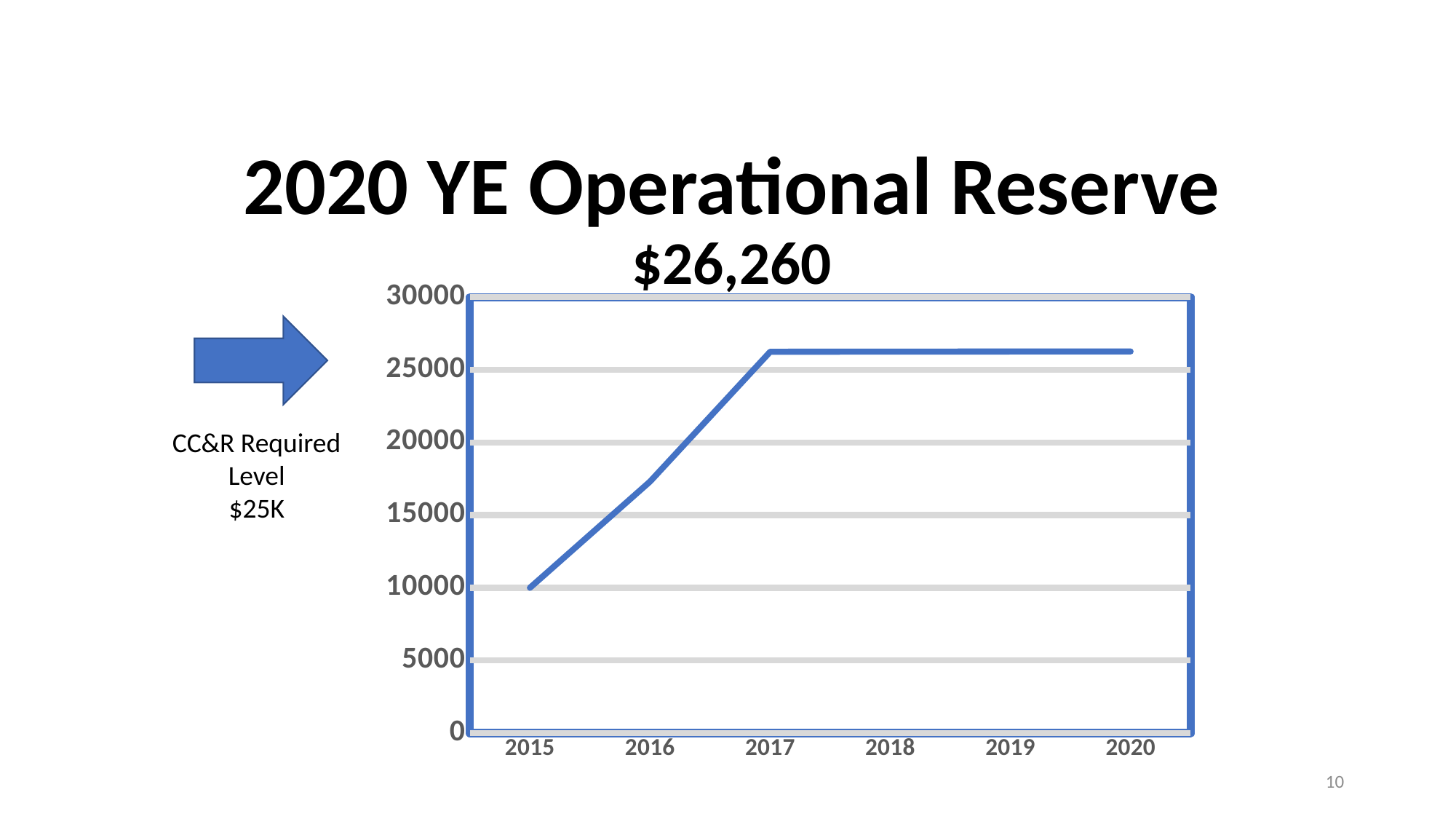
Does the operational reserve rise or fall from 2015 to 2017? rise What kind of chart is shown on the slide? line chart Which year has the lowest operational reserve value? 2015 Which year has the larger value, 2015 or 2016? 2016 What is the operational reserve value for 2015? 10000 Is the value for 2016 greater or less than 15000? greater What is the 2020 year-end operational reserve value shown on the slide? $26,260 Is the value for 2017 greater or less than 25000? greater How many years are plotted along the x axis of the chart? 6 Is the value for 2016 greater or less than 20000? less What CC&R required level is stated next to the chart? $25K